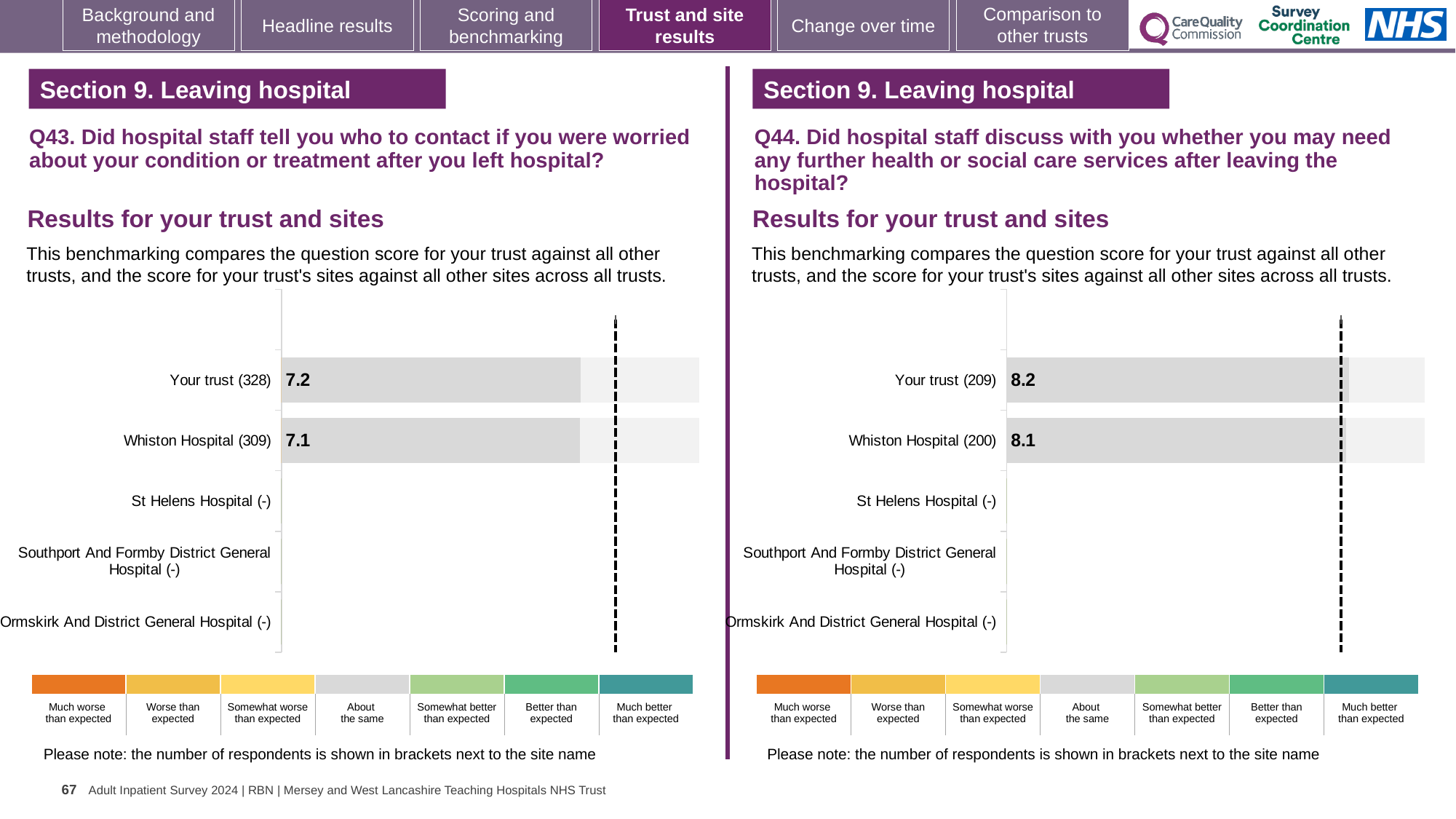
On the Q43 chart (left), what is the difference between the Your trust score and the Whiston Hospital score? 0.1 What type of chart is used on the Q44 chart (right)? Bar chart On the Q44 chart (right), what is the score for Your trust? 8.2 On the Q43 chart (left), which category has the highest score among those with a plotted value? Your trust On the Q43 chart (left), what is the score for Whiston Hospital? 7.1 On the Q43 chart (left), what is the score for Your trust? 7.2 On the Q44 chart (right), how many respondents are shown in brackets for Your trust? 209 On the Q44 chart (right), what is the score for Whiston Hospital? 8.1 On the Q44 chart (right), which has the higher score, Your trust or Whiston Hospital? Your trust How many site/trust categories are listed on the Q43 chart (left)? 5 On the Q43 chart (left), how many respondents are shown in brackets for Whiston Hospital? 309 On the Q44 chart (right), what is the difference between the Your trust score and the Whiston Hospital score? 0.1